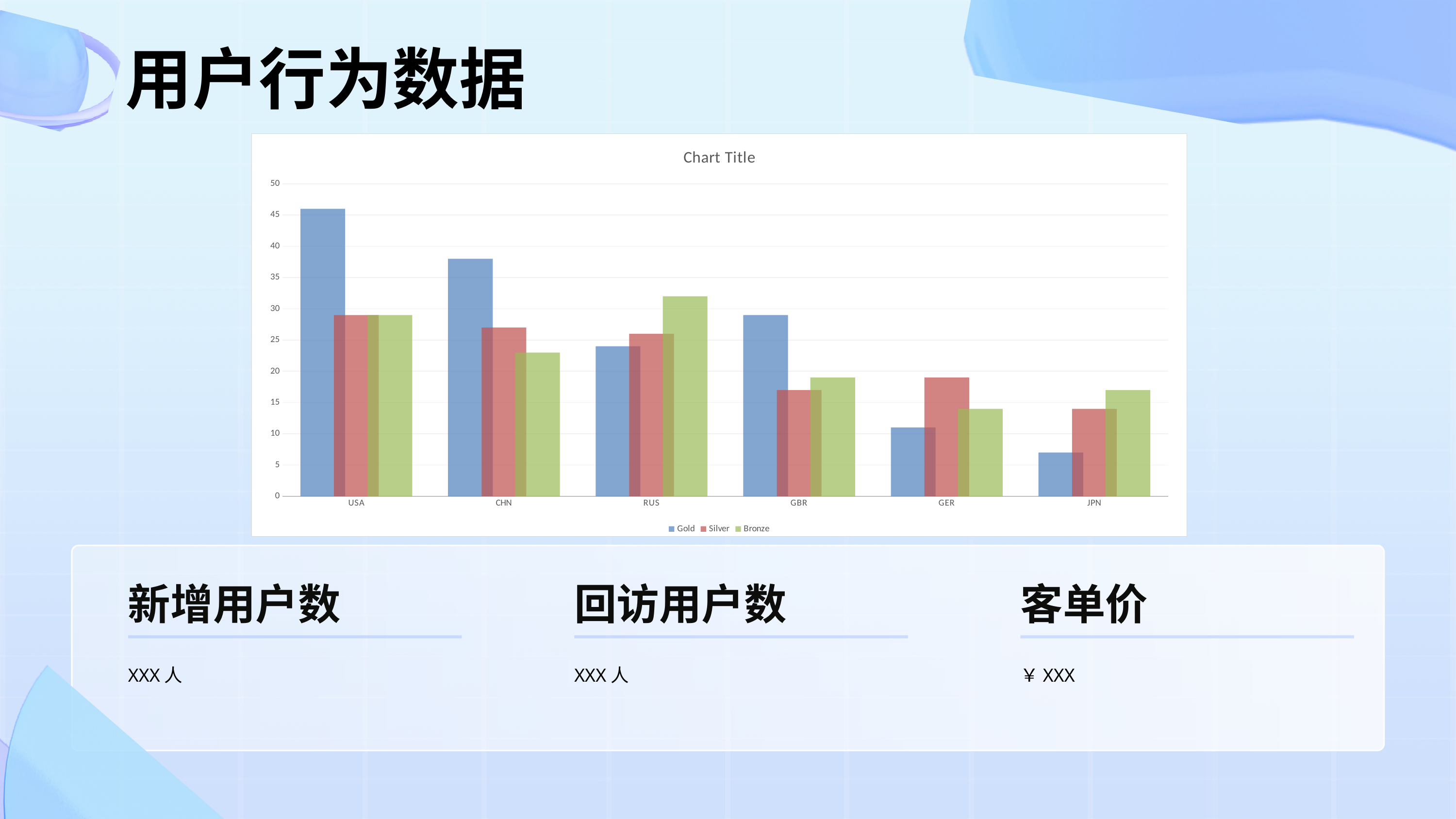
Which category has the lowest Gold value? JPN How many categories are shown on the x axis of the chart? 6 For GER, which is larger: the Gold value or the Silver value? Silver Which category has the highest Bronze value? RUS What is the title shown above the chart? Chart Title Which category has the highest Gold value? USA Is the Bronze value for RUS greater or less than 30? greater What kind of chart is shown on the slide? bar chart Is the Gold value for USA greater or less than 40? greater What are the series names listed in the chart's legend? Gold, Silver, Bronze How many series does the chart's legend list? 3 Is the Gold value for JPN greater or less than 10? less